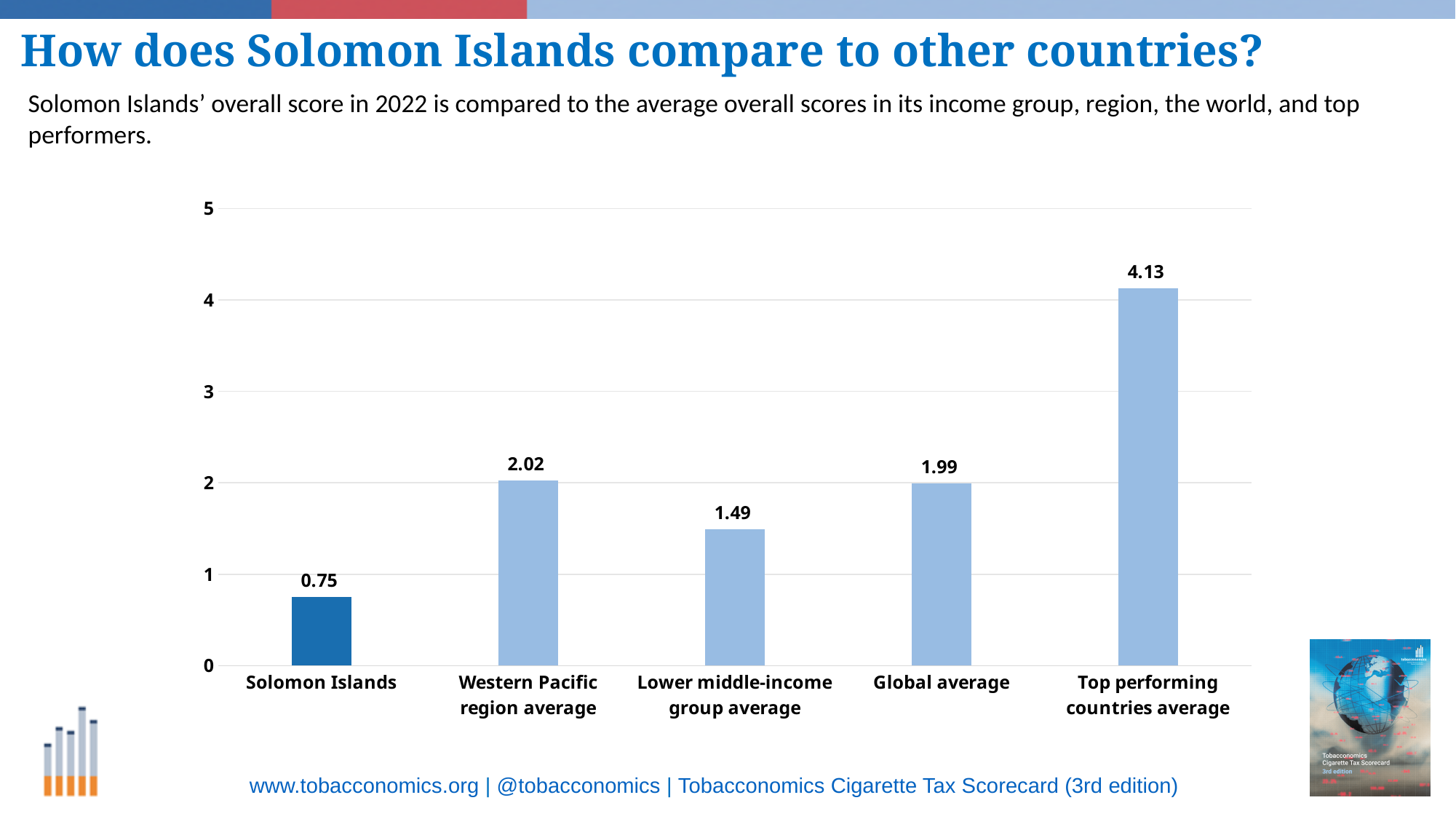
What kind of chart is shown on the slide? Bar chart Which is larger, the Global average or the Lower middle-income group average? Global average What is the value for the Western Pacific region average? 2.02 Which category has the lowest value? Solomon Islands What is the difference between the Western Pacific region average and the Global average? 0.03 What is the value for the Lower middle-income group average? 1.49 How many categories are shown in the chart? 5 Which bar is shown in a darker blue than the others? Solomon Islands What is the value for the Top performing countries average? 4.13 Which category has the highest value? Top performing countries average What is the difference between the Top performing countries average and Solomon Islands? 3.38 What is the overall score for Solomon Islands? 0.75